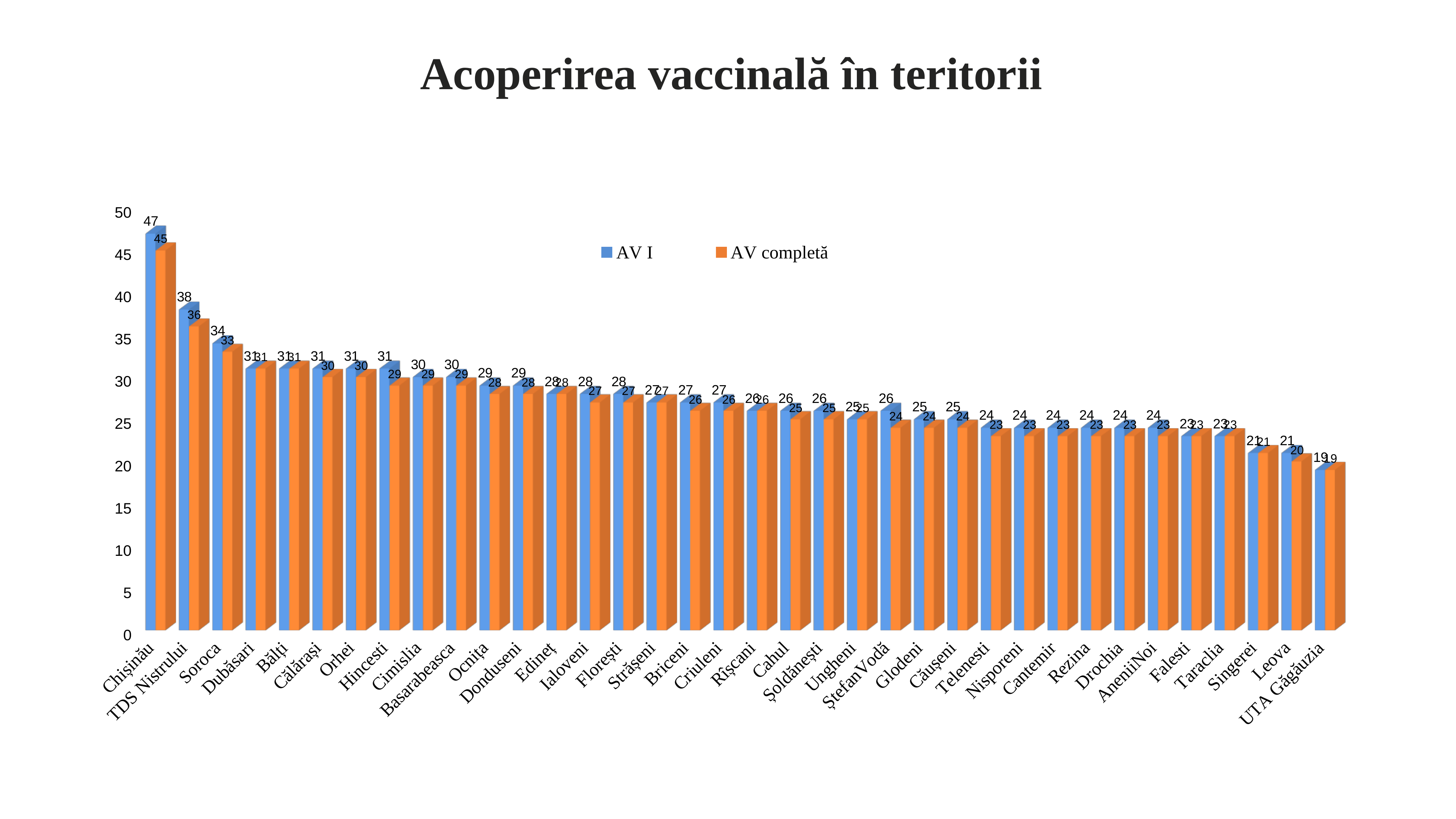
Which is larger, the AV I value for Soroca or the AV I value for Leova? Soroca What is the difference between the AV I and AV completă values for Chișinău? 2 What is the AV I value for Chișinău? 47 What kind of chart is shown on the slide? Bar chart Which territory has the lowest AV completă value? UTA Găgăuzia How many territories are shown on the x axis? 36 Which territory has the highest AV I value? Chișinău How many series does the legend list? 2 What is the difference between the AV I values for TDS Nistrului and Soroca? 4 Do the AV I values rise or fall from left to right along the x axis? Fall What is the AV completă value for Soroca? 33 What is the AV completă value for TDS Nistrului? 36